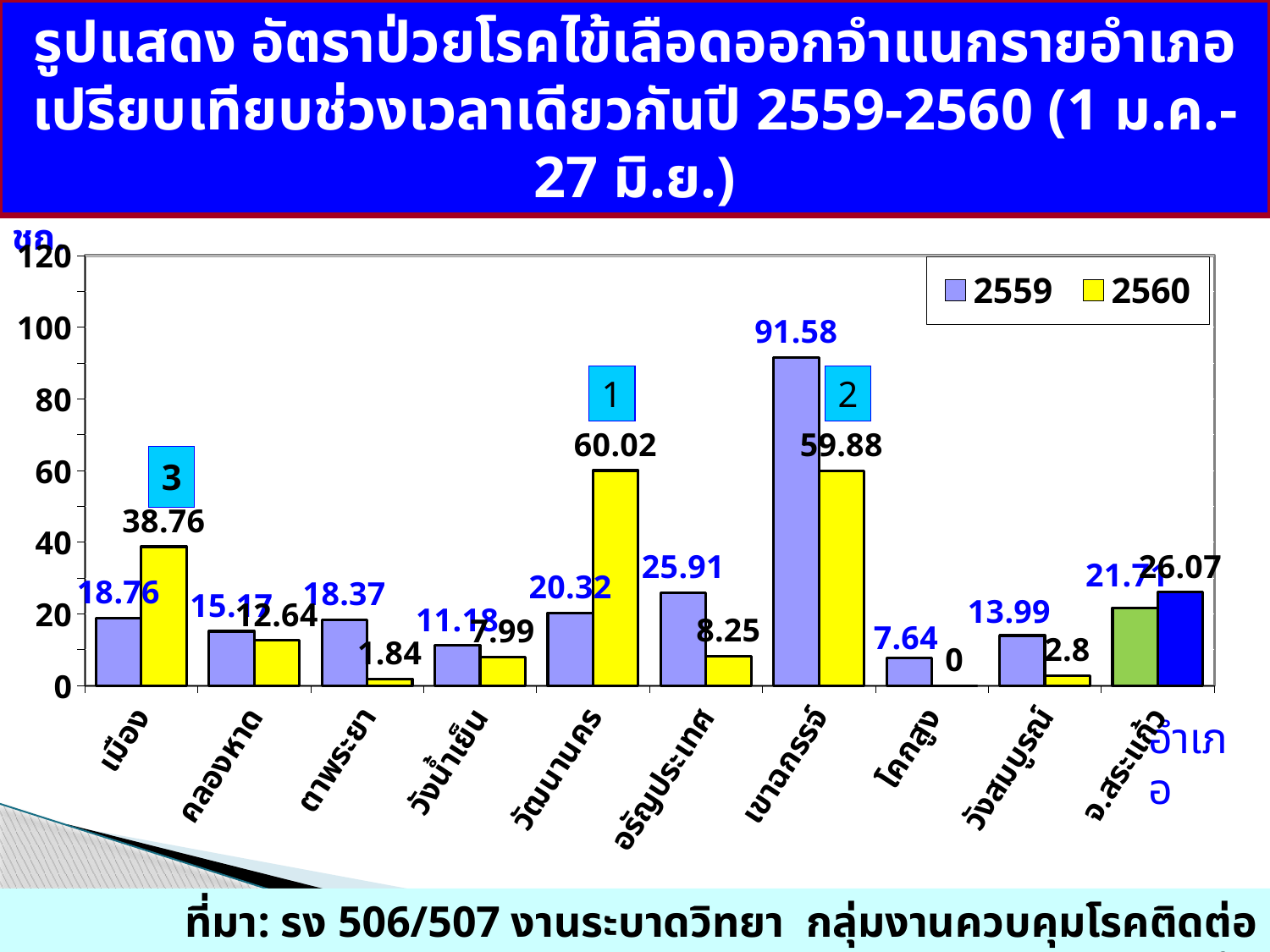
What is the value for เขาฉกรรจ์ in the 2559 series? 91.58 What is the value for เมือง in the 2560 series? 38.76 Which district has the highest value in the 2559 series? เขาฉกรรจ์ Is the 2559 value for เขาฉกรรจ์ greater or less than 80? greater What is the value for ตาพระยา in the 2560 series? 1.84 Which district has the highest value in the 2560 series? วัฒนานคร For วัฒนานคร, which series has the larger value, 2559 or 2560? 2560 How many series does the legend list? 2 Which district has the lowest value in the 2560 series? โคกสูง What is the difference between the 2560 and 2559 values for เมือง? 20 What is the difference between the 2559 and 2560 values for เขาฉกรรจ์? 31.7 How many districts are shown on the x axis? 10